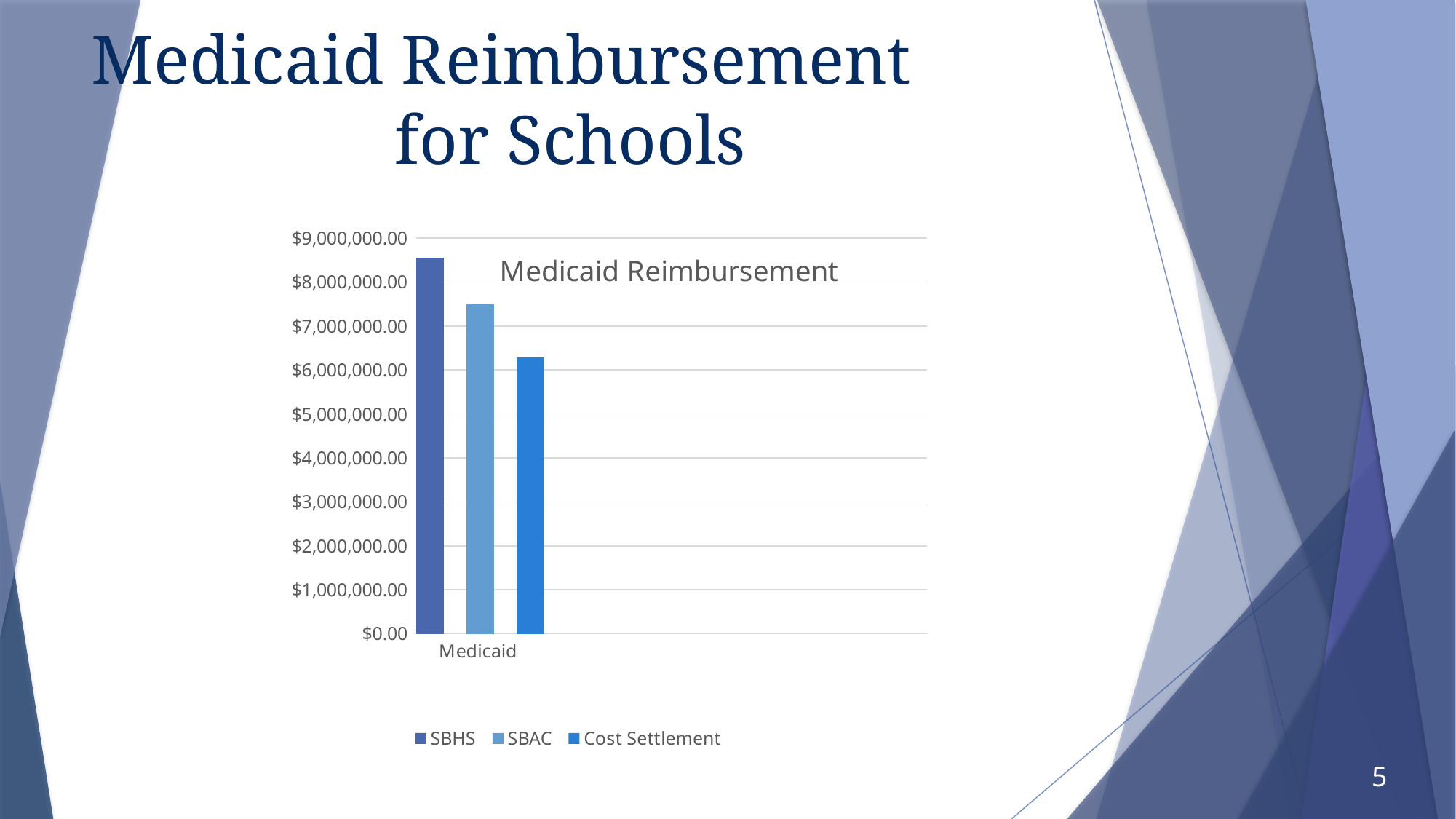
What kind of chart is shown on the slide? bar chart Which series has the lowest value? Cost Settlement What is the title of the chart? Medicaid Reimbursement Which is larger, the value for SBAC or the value for Cost Settlement? SBAC What is the label of the category on the x axis? Medicaid How many series does the legend list? 3 How many categories are shown on the x axis? 1 Is the value for Cost Settlement greater or less than $6,000,000.00? greater Is the value for SBHS greater or less than $8,000,000.00? greater Is the value for SBAC greater or less than $8,000,000.00? less Which is larger, the value for SBHS or the value for SBAC? SBHS Which series has the highest value? SBHS